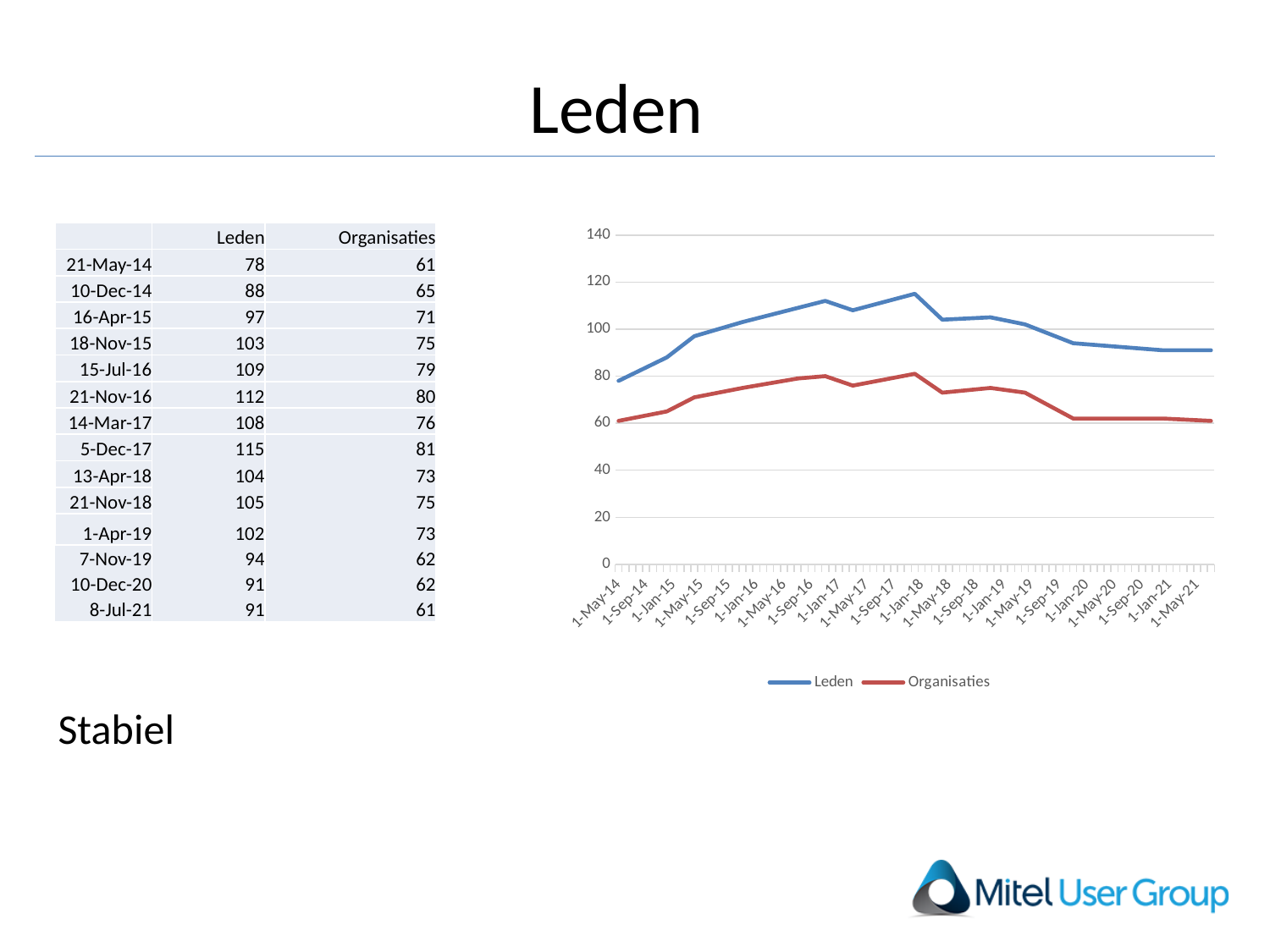
How many series does the chart legend list? 2 Which series has the higher values throughout the chart, Leden or Organisaties? Leden What are the two series named in the chart legend? Leden and Organisaties What is the Organisaties value on 21-May-14? 61 What is the lowest Leden value in the data? 78 What is the highest Organisaties value reached? 81 Is the Leden value around 1-Jan-18 greater or less than 100? greater What is the difference between Leden and Organisaties on 8-Jul-21? 30 What kind of chart is shown on the slide? line chart Do the Leden values rise or fall between 2019 and 2021? fall What is the highest Leden value reached? 115 What is the Leden value on 5-Dec-17? 115